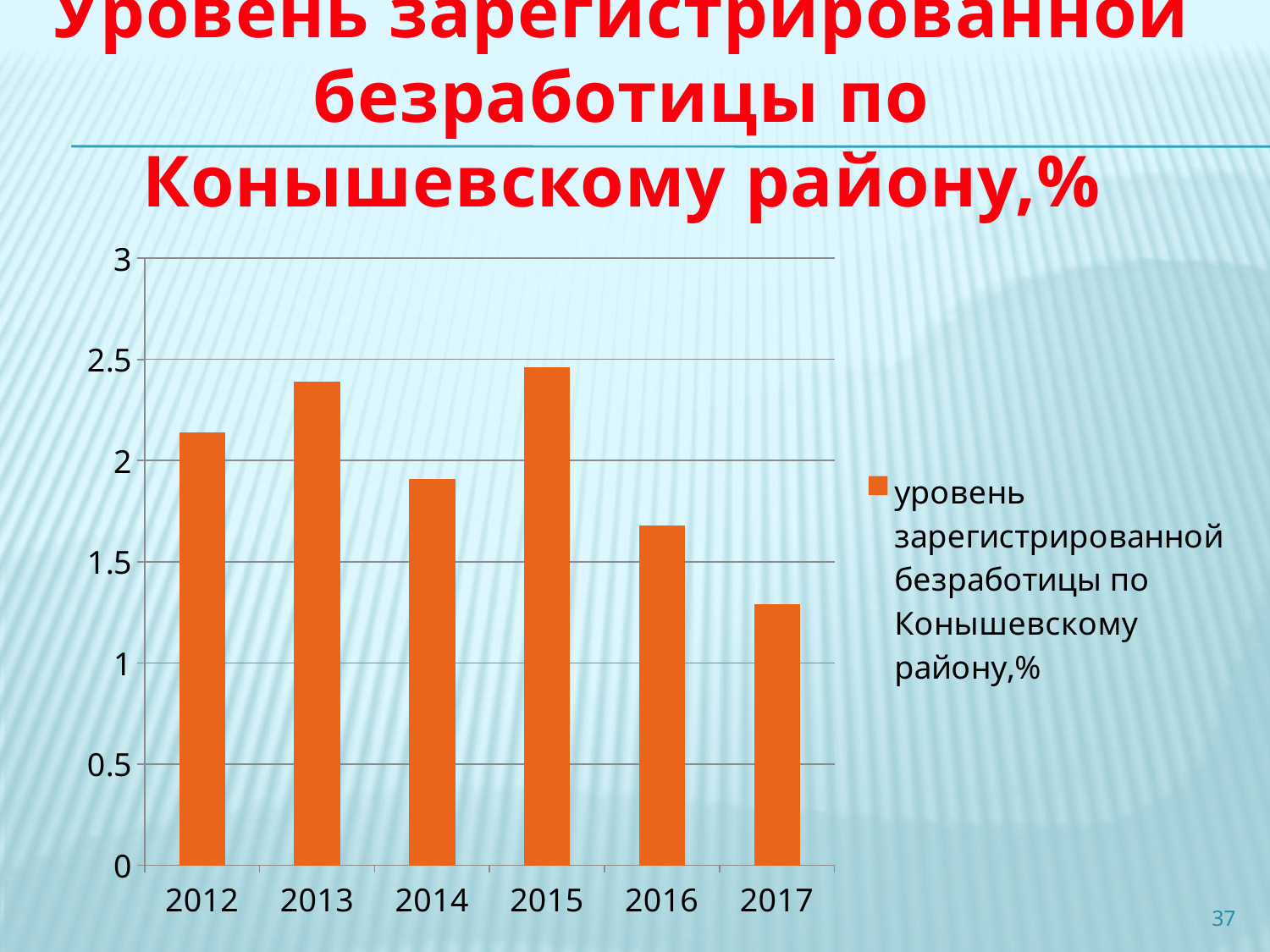
Which year has the lowest registered unemployment rate? 2017 Is the value for 2017 greater or less than 1.5? less How many series does the legend list? 1 Is the value for 2013 greater or less than 2? greater How many years are shown on the x axis of the chart? 6 Do the values rise or fall from 2015 to 2017? fall What colour are the bars in the chart? orange What kind of chart is shown on the slide? bar chart Is the value for 2014 greater or less than 2? less Which is larger, the value for 2012 or the value for 2017? 2012